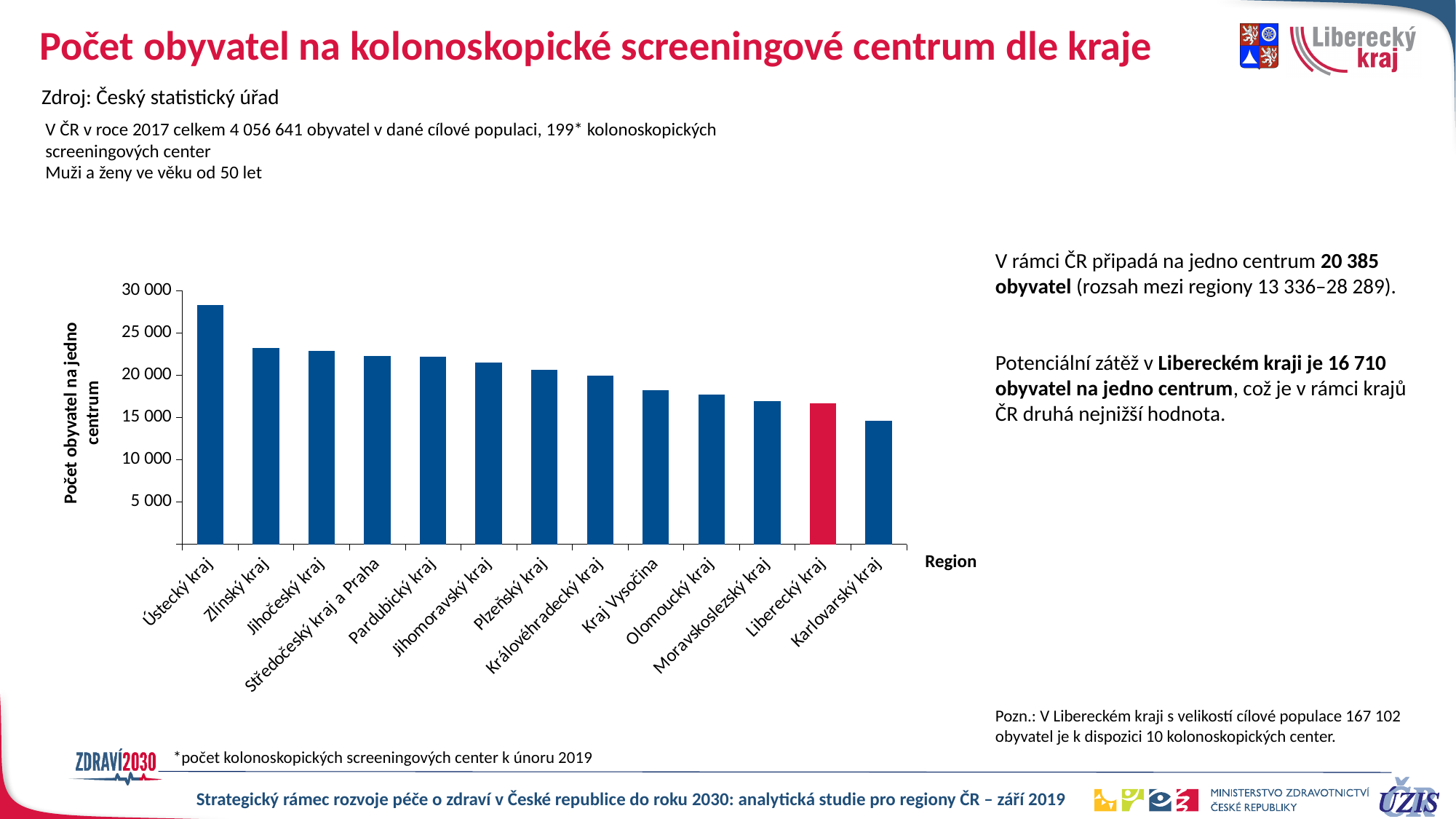
Do the bar values rise or fall from left to right along the x axis? fall Which has a larger value, Ústecký kraj or Zlínský kraj? Ústecký kraj Is the value for Olomoucký kraj greater or less than 20 000? less What kind of chart is shown on the slide? bar chart Which region has the lowest number of inhabitants per colonoscopy screening centre? Karlovarský kraj Which region's bar is highlighted in red? Liberecký kraj Is the value for Zlínský kraj greater or less than 20 000? greater Is the value for Ústecký kraj greater or less than 25 000? greater How many regions (categories) are plotted on the x axis? 13 Which region has the highest number of inhabitants per colonoscopy screening centre? Ústecký kraj According to the slide, how many inhabitants per centre does Liberecký kraj have? 16 710